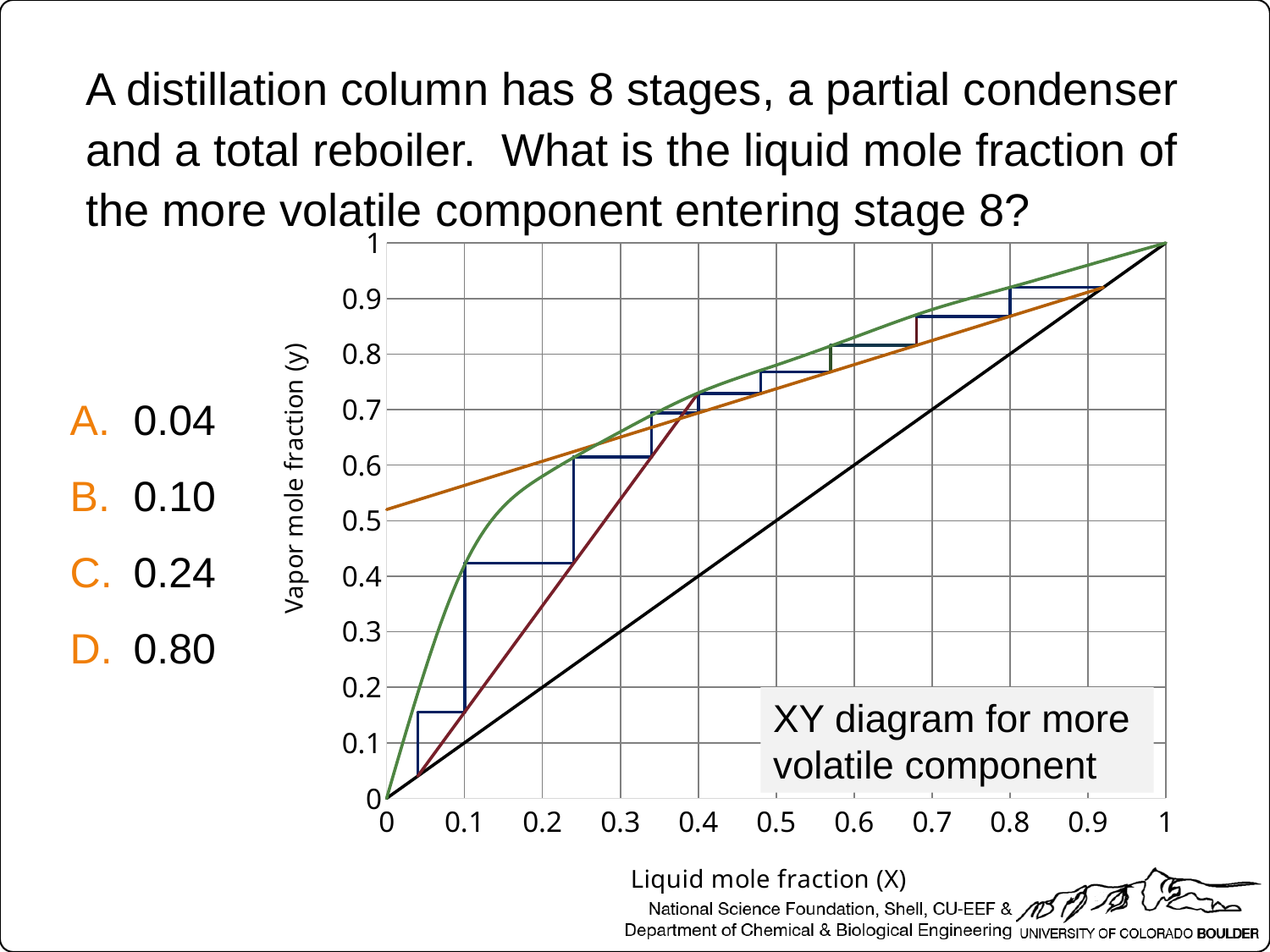
What is the highest value shown on the y axis of the chart? 1 Does the green equilibrium curve rise or fall as the liquid mole fraction increases from 0 to 1? rise At a liquid mole fraction of 0.2, is the value of the red line greater or less than 0.5? less What is the spacing between consecutive tick marks on the x axis of the chart? 0.1 What is the label of the x axis of the chart? Liquid mole fraction (X) Where the orange line meets the y axis (liquid mole fraction 0), is its value greater or less than 0.4? greater At a liquid mole fraction of 0.1, is the value of the green equilibrium curve greater or less than 0.3? greater At a liquid mole fraction of 0.3, which is higher: the green equilibrium curve or the black diagonal line? the green equilibrium curve What is the lowest value shown on the x axis of the chart? 0 What kind of chart is shown on the slide? line chart What is the title shown on the chart? XY diagram for more volatile component